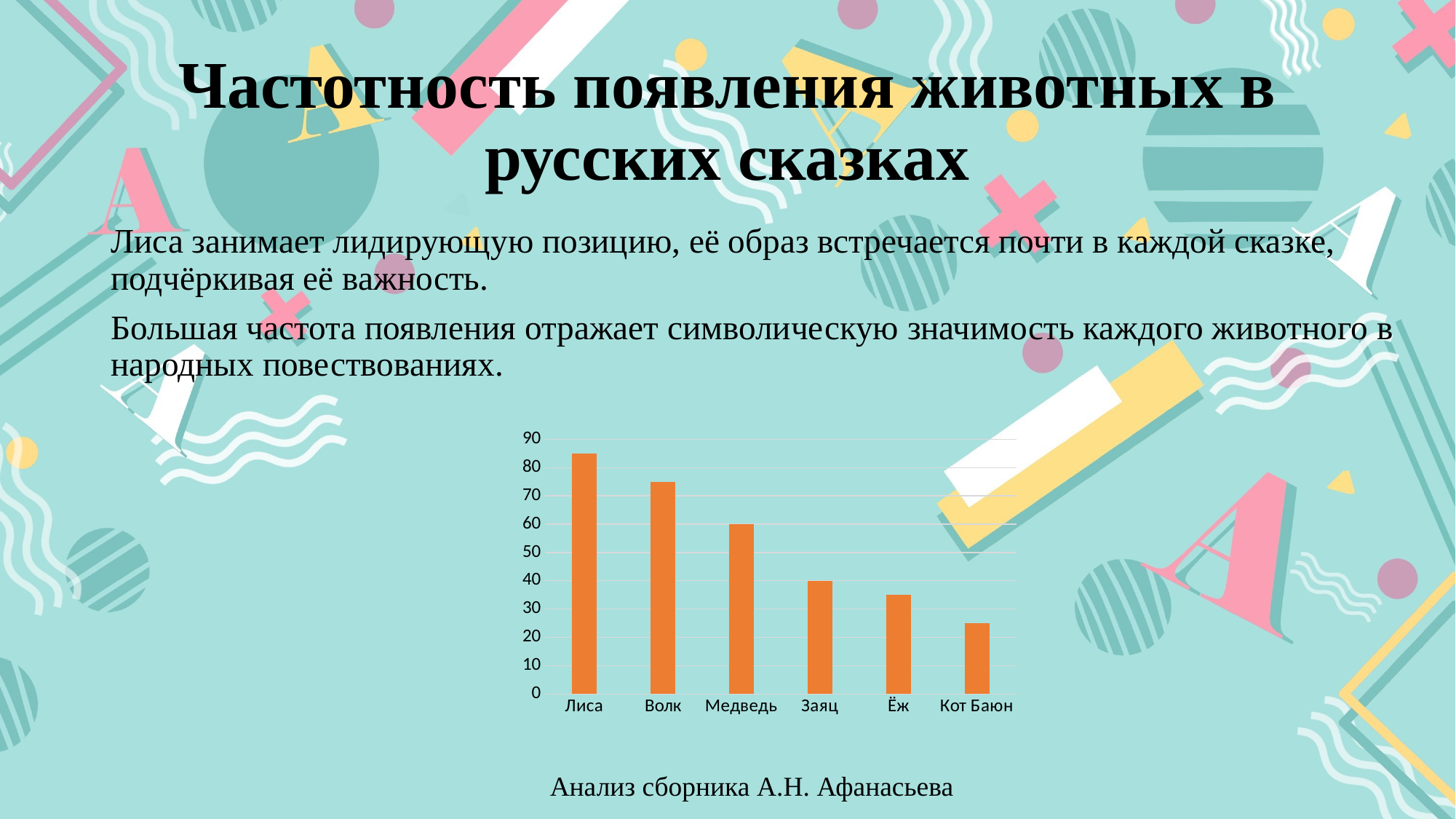
How many animal categories are shown on the x axis of the chart? 6 Which has a larger value in the chart, Волк or Медведь? Волк Is the value for Кот Баюн greater or less than 30? less Which animal has the lowest bar in the chart? Кот Баюн Is the value for Лиса greater or less than 80? greater Is the value for Ёж greater or less than 40? less What is the highest value shown on the vertical axis of the chart? 90 Do the bar values rise or fall from left to right along the x axis? fall What kind of chart is shown on the slide? bar chart Which has a larger value in the chart, Заяц or Кот Баюн? Заяц Which animal has the highest bar in the chart? Лиса